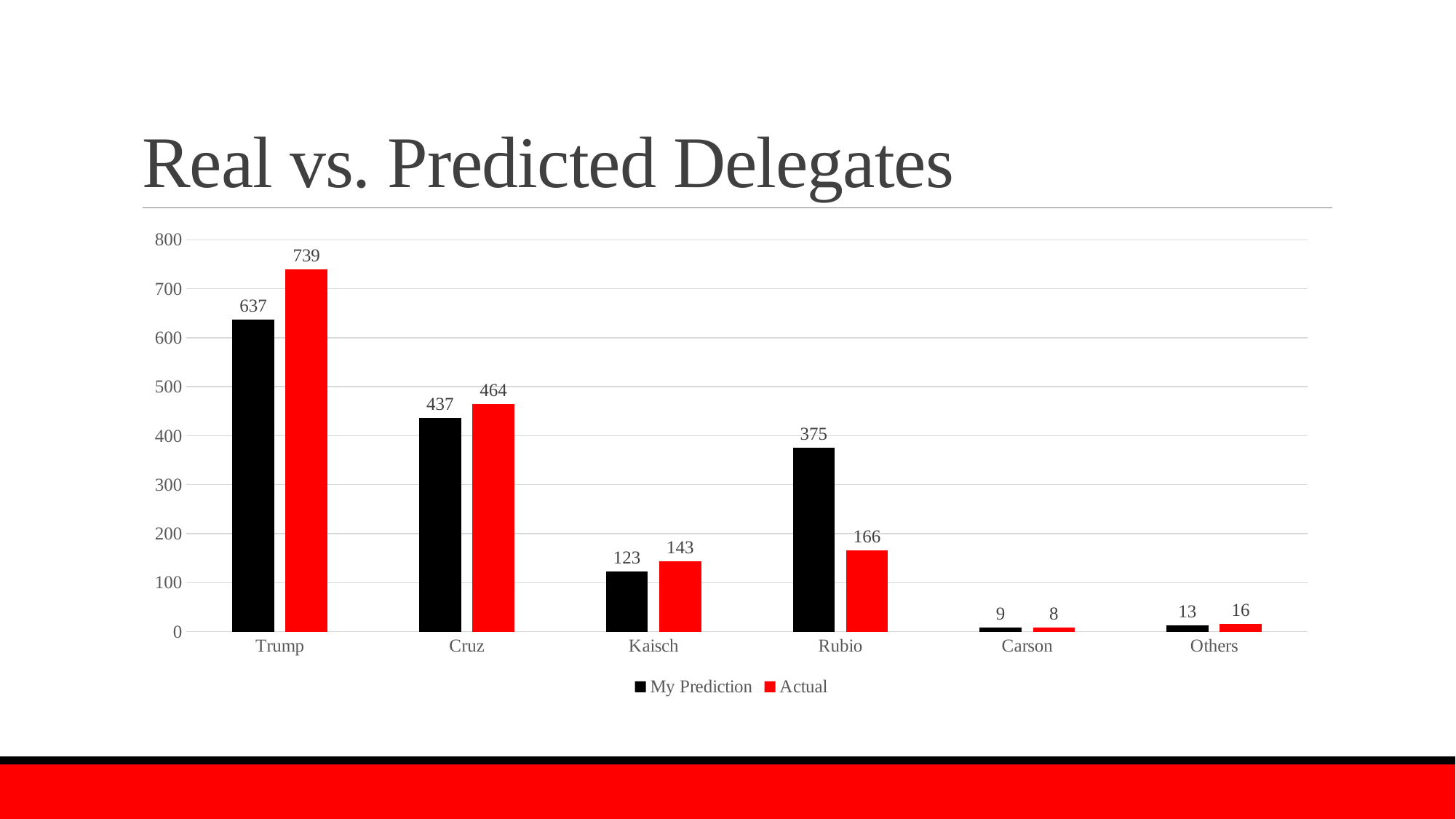
Which category has the lowest My Prediction value? Carson Which is larger for Cruz, My Prediction or Actual? Actual What is the difference between the Actual and My Prediction values for Trump? 102 Which category has the highest Actual value? Trump What is the title of the slide? Real vs. Predicted Delegates How many series does the legend list? 2 What is the difference between the My Prediction and Actual values for Rubio? 209 What kind of chart is shown on the slide? Bar chart How many categories are shown on the x axis? 6 What is the My Prediction value for Rubio? 375 What is the Actual value for Kaisch? 143 What is the Actual value for Trump? 739